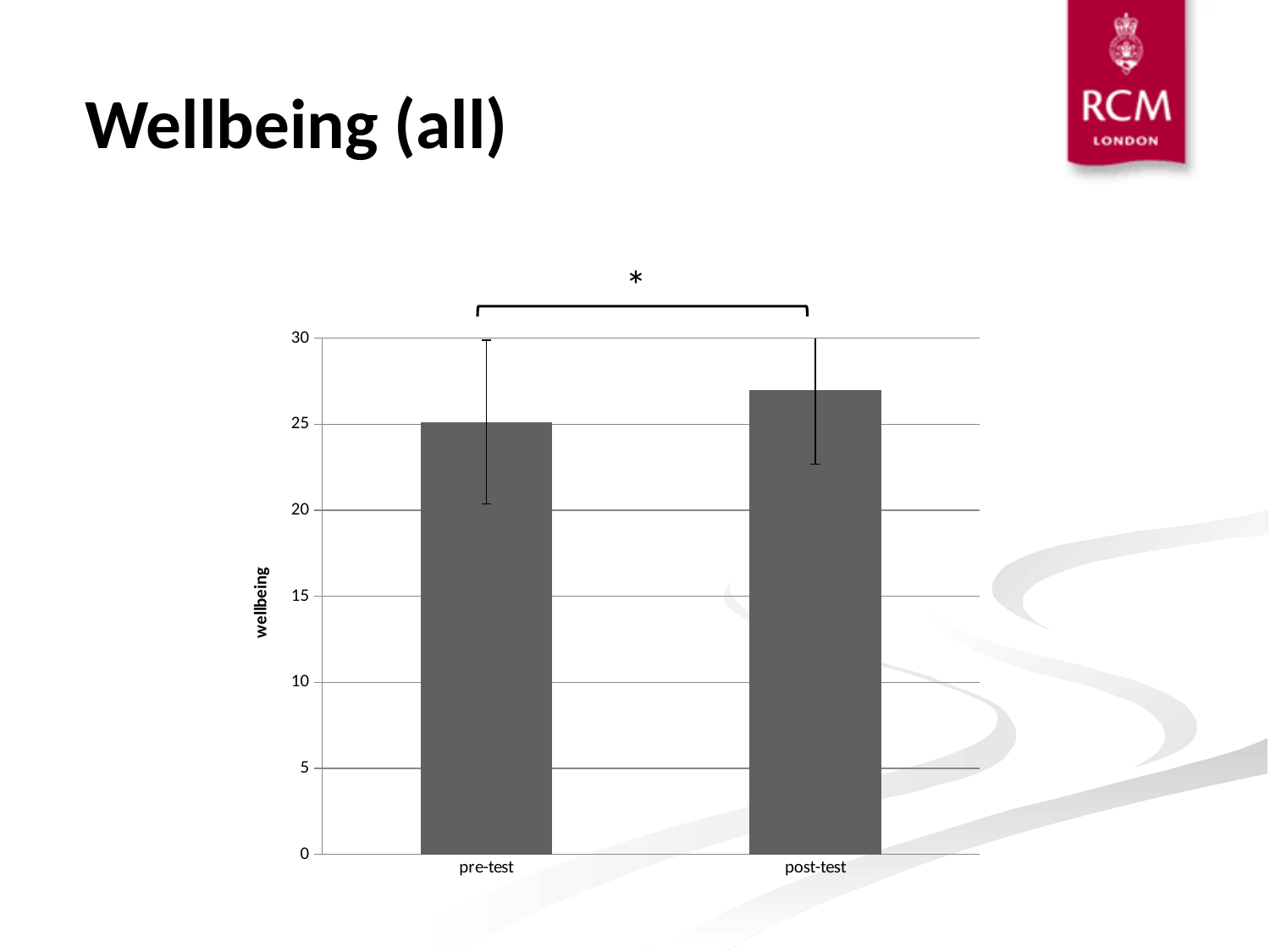
Is the wellbeing value for post-test larger or smaller than the value for pre-test? larger Do the bar values rise or fall from pre-test to post-test? rise Is the value for post-test greater or less than 30? less Which category has the higher wellbeing value? post-test Is the value for pre-test greater or less than 20? greater How many categories are plotted on the x axis? 2 What kind of chart is shown on the slide? bar chart What is the title of the slide containing the chart? Wellbeing (all) Which category has the lower wellbeing value? pre-test Is the value for post-test greater or less than 25? greater What is the label on the vertical axis of the chart? wellbeing